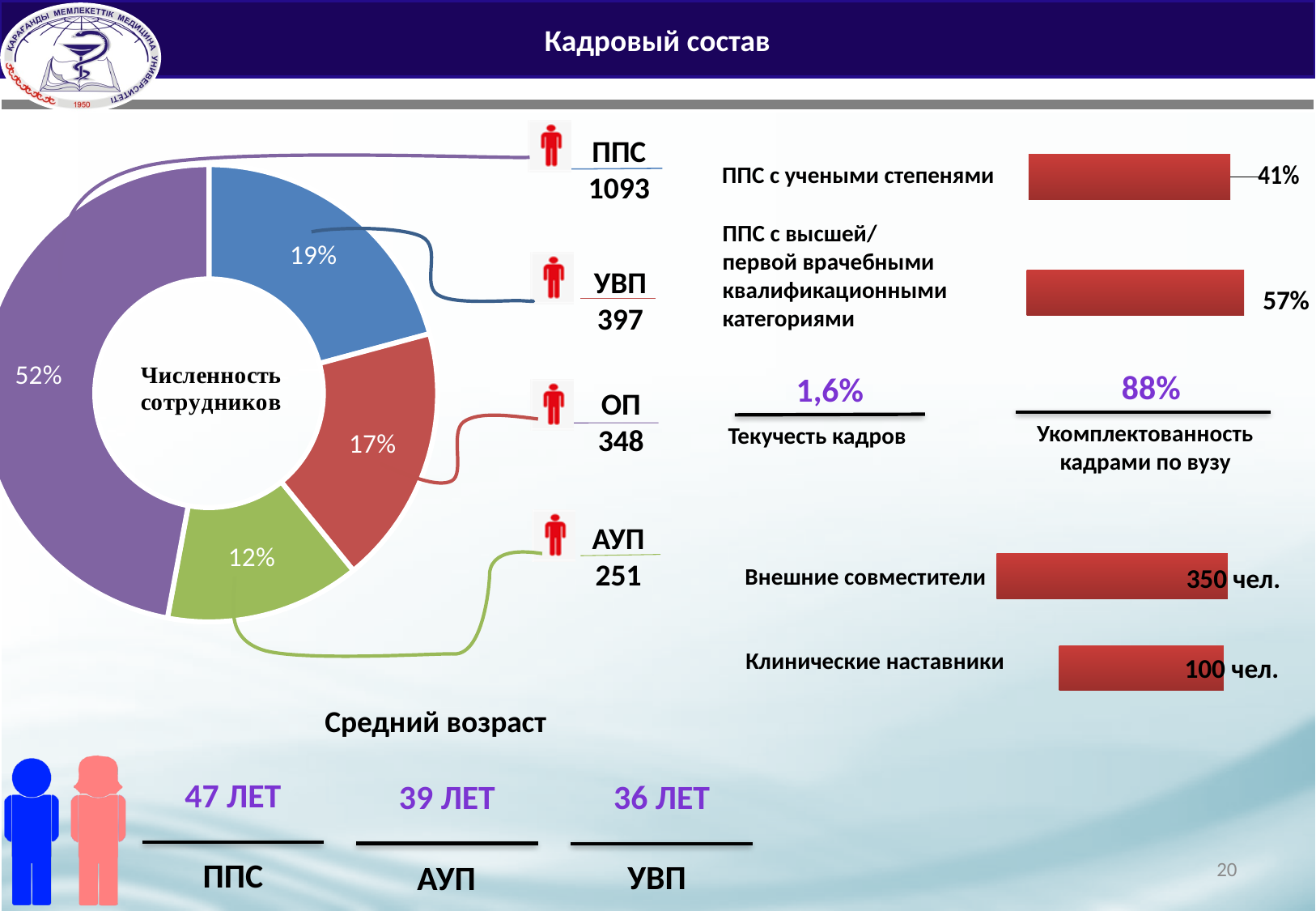
In the "Численность сотрудников" donut chart, how many slices are there? 4 In the "Численность сотрудников" donut chart, what is the headcount shown for ОП? 348 In the "Численность сотрудников" donut chart, what is the difference in headcount between ППС (1093) and УВП (397)? 696 In the bars on the right of the slide, what value is shown for "ППС с высшей/первой врачебными квалификационными категориями"? 57% What kind of chart is the "Численность сотрудников" chart on the left of the slide? Donut (pie) chart In the "Численность сотрудников" donut chart, what share does the АУП slice have? 12% In the "Численность сотрудников" donut chart, which category has the largest slice? ППС In the bars on the right of the slide, what is the difference between "Внешние совместители" (350 чел.) and "Клинические наставники" (100 чел.)? 250 чел. In the "Численность сотрудников" donut chart, what share does the ППС slice have? 52% In the "Численность сотрудников" donut chart, which is larger: the ОП slice or the УВП slice? УВП In the "Численность сотрудников" donut chart, which category has the smallest slice? АУП In the "Численность сотрудников" donut chart, what share does the УВП slice have? 19%